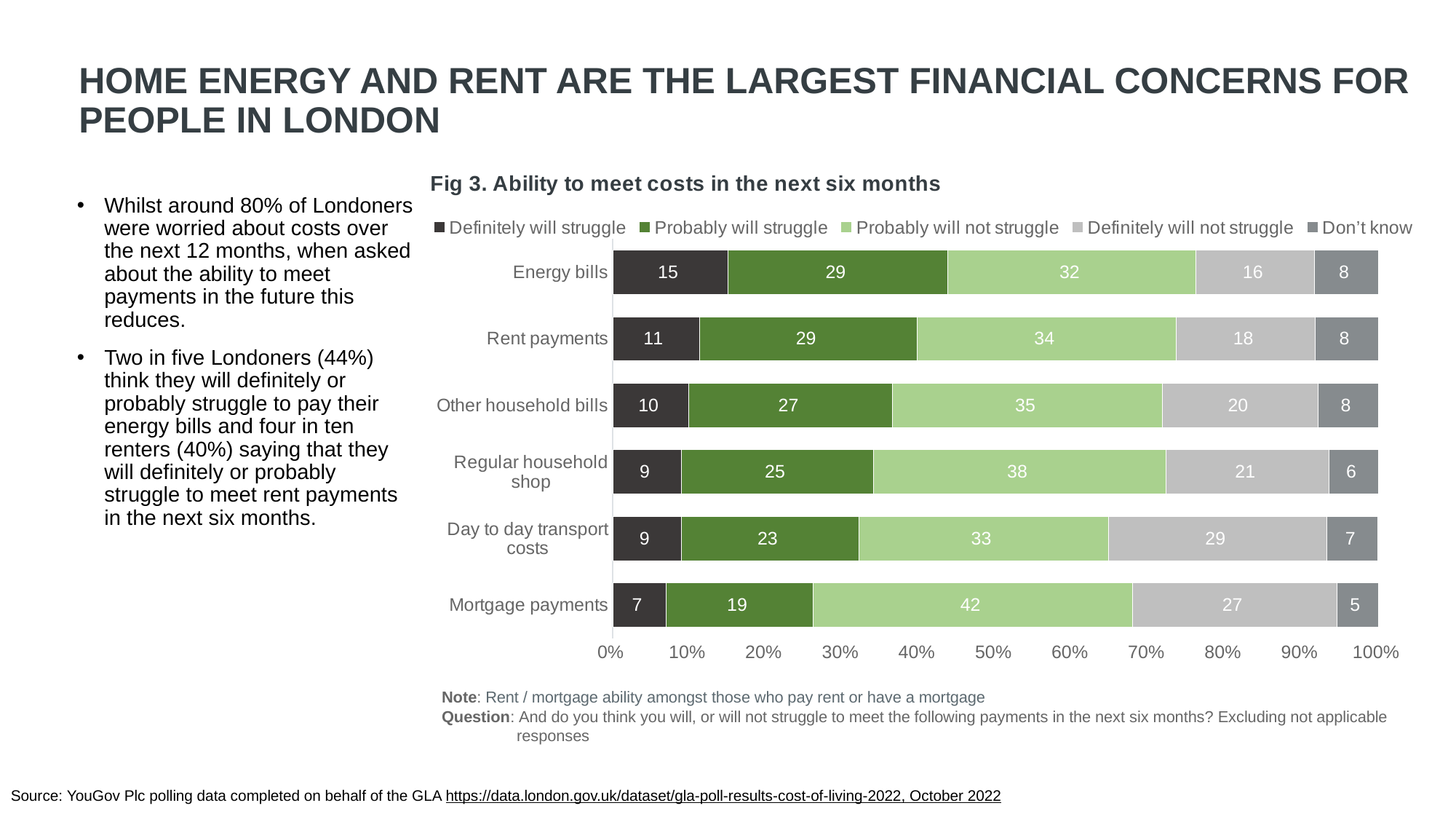
What kind of chart is shown? Stacked bar chart Which category has the highest 'Definitely will struggle' value? Energy bills What is the 'Probably will not struggle' value for Mortgage payments? 42 What is the 'Definitely will struggle' value for Energy bills? 15 How many categories are shown on the chart? 6 What is the title of the chart? Fig 3. Ability to meet costs in the next six months Which is larger: the 'Definitely will not struggle' value for Rent payments or for Regular household shop? Regular household shop What is the difference between the 'Probably will not struggle' values for Mortgage payments and Energy bills? 10 Which category has the lowest 'Probably will struggle' value? Mortgage payments What is the combined 'Definitely will struggle' and 'Probably will struggle' total for Rent payments? 40 What is the 'Definitely will not struggle' value for Day to day transport costs? 29 How many series does the legend list? 5